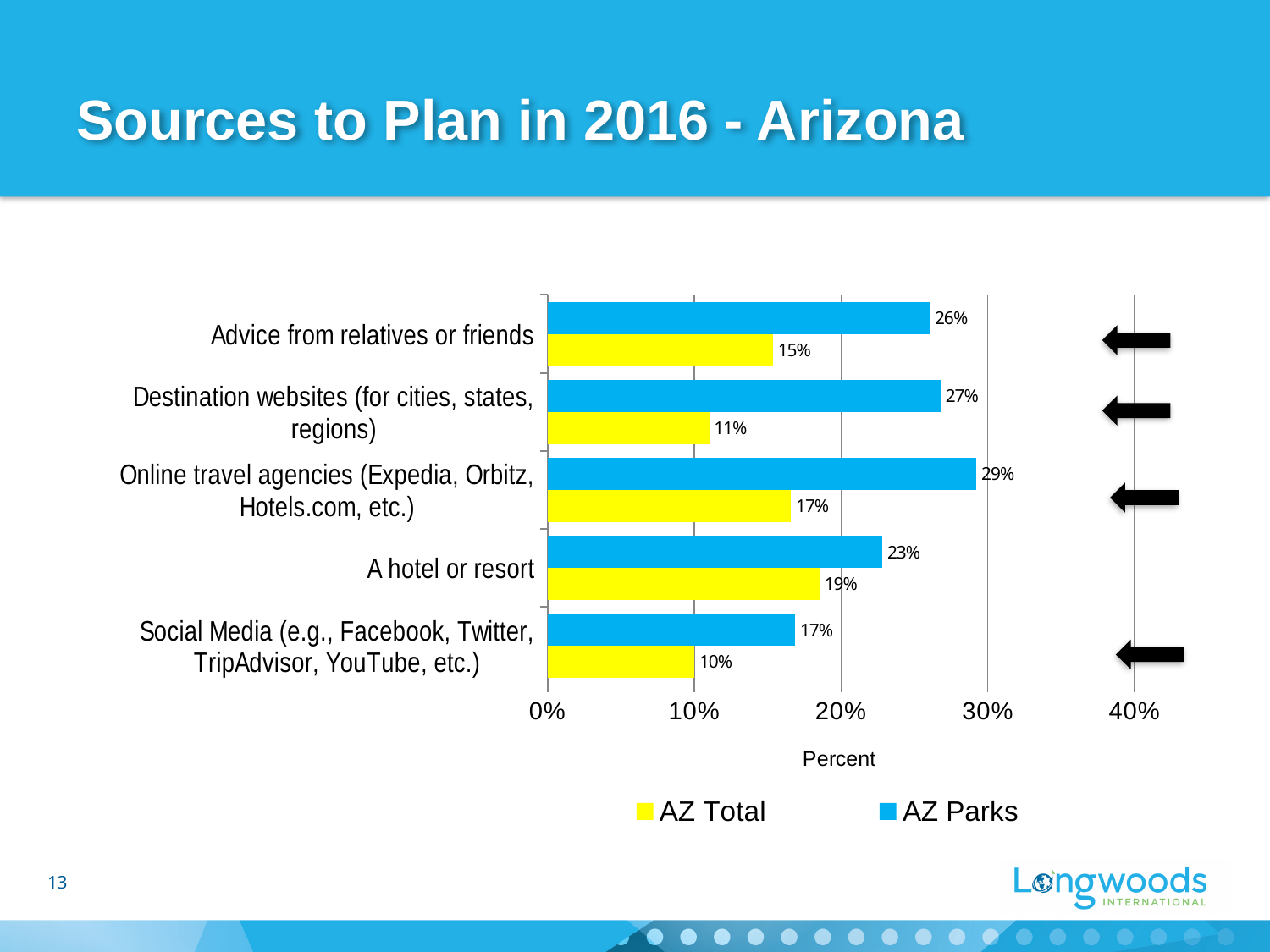
Which category has the lowest AZ Total value? Social Media (e.g., Facebook, Twitter, TripAdvisor, YouTube, etc.) What is the difference between the AZ Parks and AZ Total values for Destination websites (for cities, states, regions)? 16% How many categories are shown on the chart? 5 Is the AZ Parks value for A hotel or resort greater or less than 20%? greater How many series does the legend list? 2 What is the AZ Parks value for Online travel agencies (Expedia, Orbitz, Hotels.com, etc.)? 29% What is the title of the chart on the slide? Sources to Plan in 2016 - Arizona Which category has the highest AZ Parks value? Online travel agencies (Expedia, Orbitz, Hotels.com, etc.) Which is larger for Advice from relatives or friends: the AZ Parks value or the AZ Total value? AZ Parks What is the AZ Total value for A hotel or resort? 19% What kind of chart is shown on the slide? Bar chart What is the AZ Total value for Destination websites (for cities, states, regions)? 11%